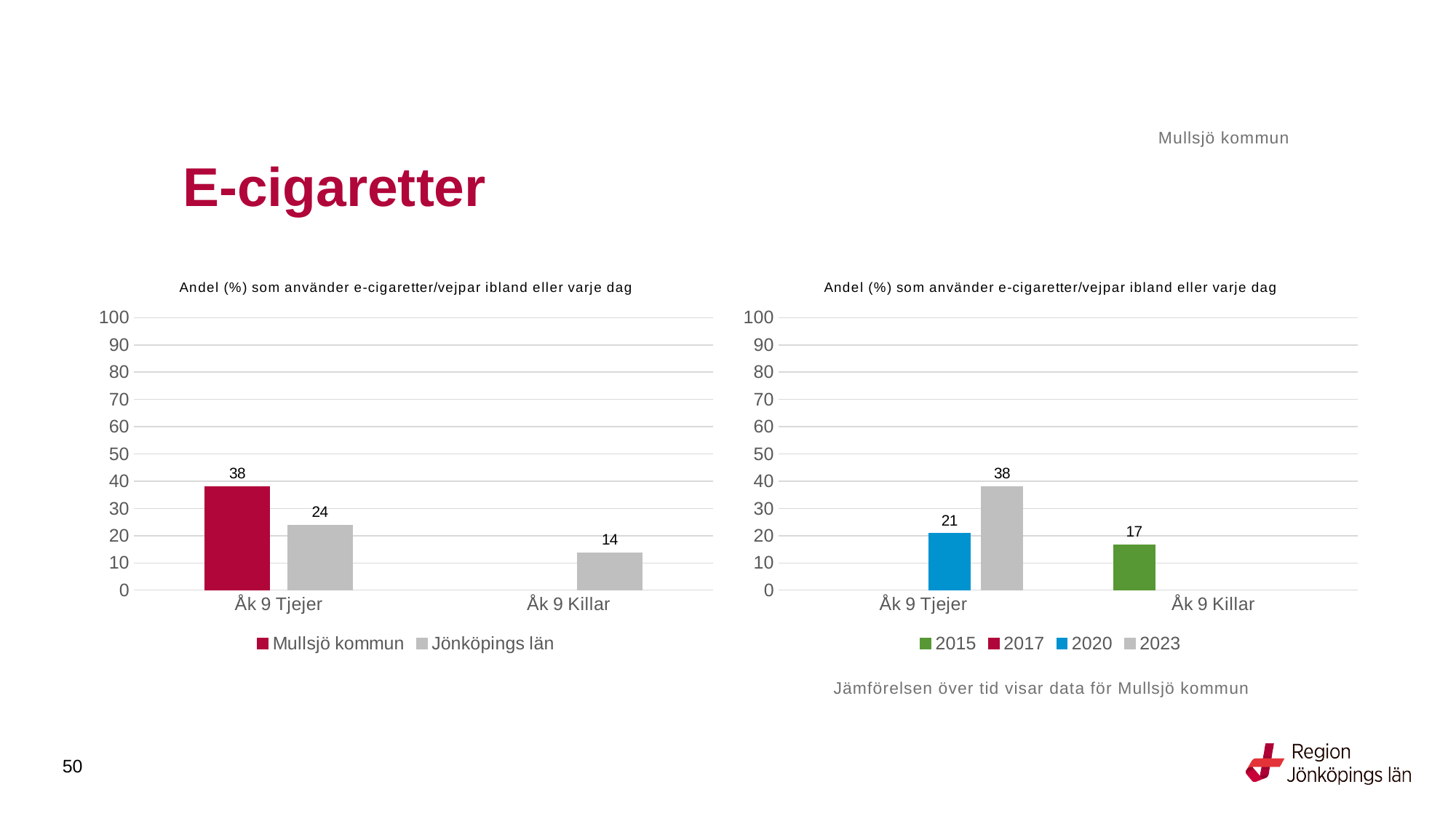
In the left chart, what is the difference between Mullsjö kommun and Jönköpings län for Åk 9 Tjejer? 14 In the left chart, which is larger for Åk 9 Tjejer: Mullsjö kommun or Jönköpings län? Mullsjö kommun How many series does the legend of the left chart list? 2 In the right chart, what is the difference between the 2023 and 2020 values for Åk 9 Tjejer? 17 In the left chart, what is the value for Jönköpings län for Åk 9 Tjejer? 24 How many series does the legend of the right chart list? 4 What kind of chart is the left chart? bar chart In the left chart, what is the value for Jönköpings län for Åk 9 Killar? 14 In the right chart, what is the value for 2015 for Åk 9 Killar? 17 In the right chart, what is the value for 2020 for Åk 9 Tjejer? 21 In the right chart, what is the value for 2023 for Åk 9 Tjejer? 38 In the left chart, what is the value for Mullsjö kommun for Åk 9 Tjejer? 38